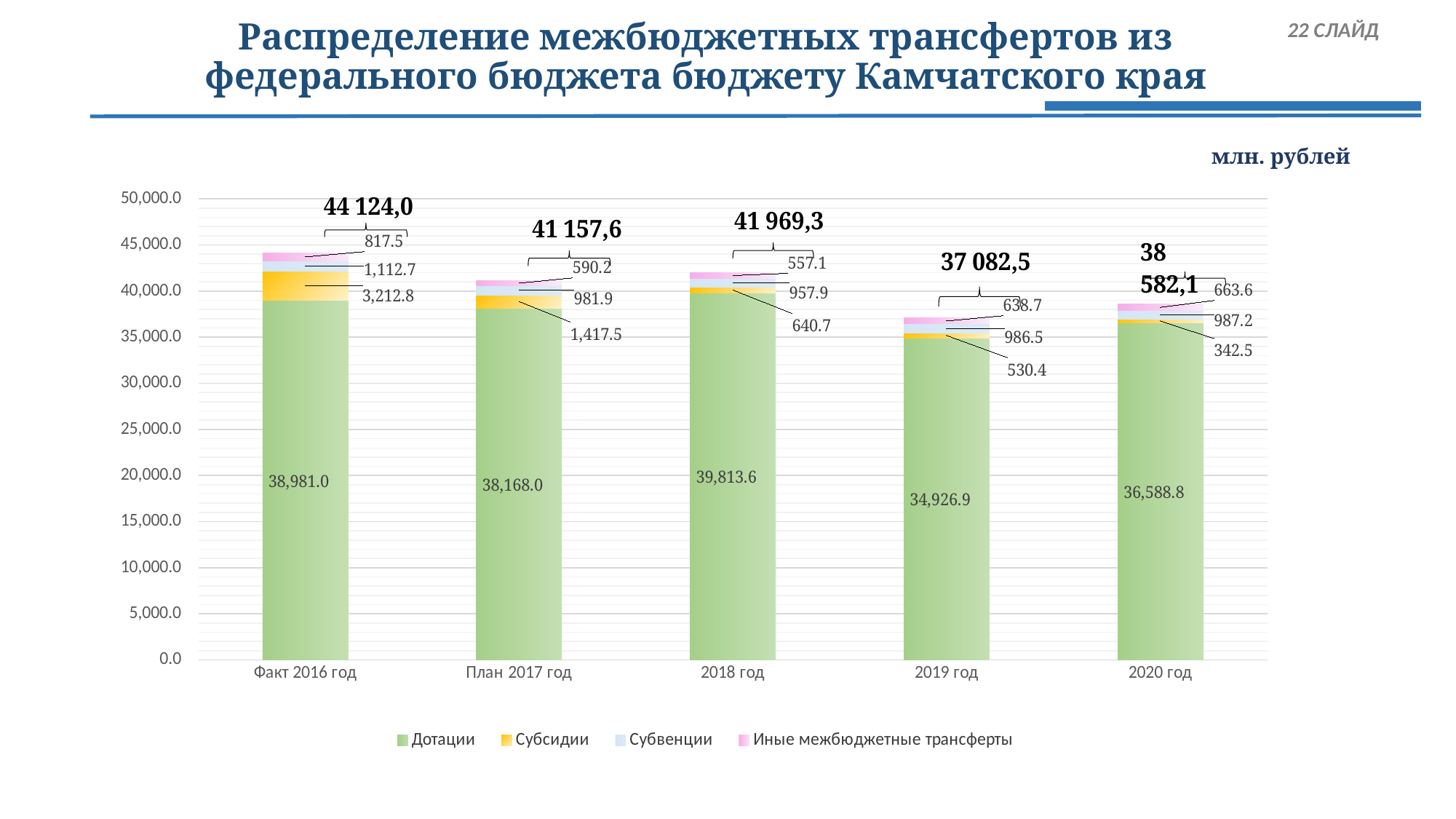
What is the difference between the Дотации values for 2018 год and 2019 год? 4,886.7 How many categories are shown on the x axis? 5 What is the value of Субсидии for План 2017 год? 1,417.5 What is the value of Дотации for Факт 2016 год? 38,981.0 What is the total shown above the bar for 2018 год? 41 969,3 How many series does the legend list? 4 What is the value of Субвенции for 2019 год? 986.5 What is the value of Иные межбюджетные трансферты for 2020 год? 663.6 Is the Дотации value for План 2017 год greater or less than 40,000.0? less Which category has the highest value of Субсидии? Факт 2016 год What kind of chart is shown on the slide? Stacked bar chart Which category has the lowest value of Дотации? 2019 год